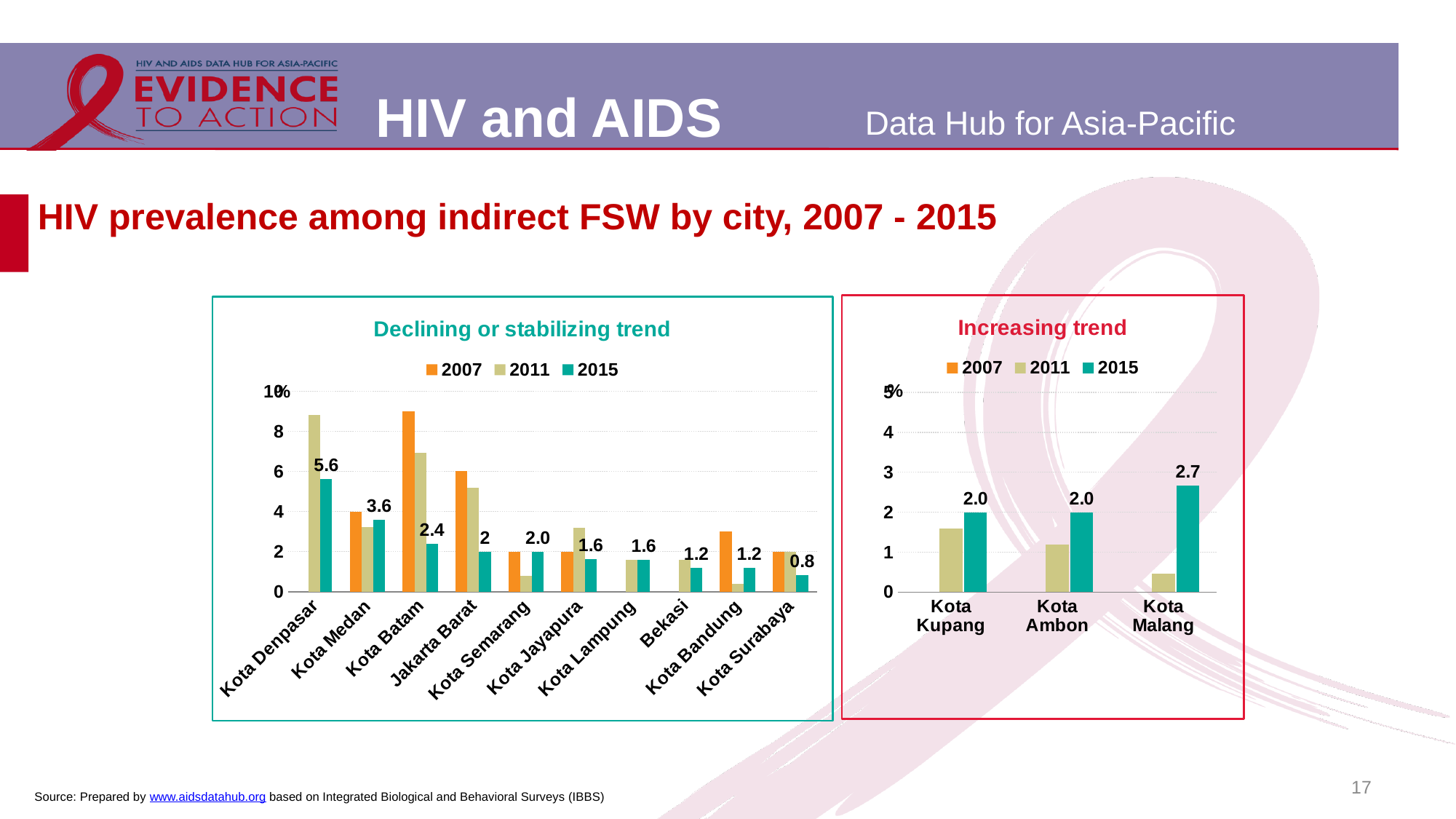
In the 'Increasing trend' chart, which city has the highest 2015 value? Kota Malang How many cities are shown in the 'Declining or stabilizing trend' chart? 10 In the 'Declining or stabilizing trend' chart, which is larger: the 2007 value for Kota Batam or the 2007 value for Kota Medan? Kota Batam In the 'Declining or stabilizing trend' chart, which city has the highest 2015 value? Kota Denpasar In the 'Increasing trend' chart, what is the 2015 value for Kota Malang? 2.7 In the 'Declining or stabilizing trend' chart, is the 2007 value for Kota Batam greater or less than 8? greater In the 'Declining or stabilizing trend' chart, what is the 2015 value for Kota Denpasar? 5.6 How many series does the legend of the 'Increasing trend' chart list? 3 In the 'Declining or stabilizing trend' chart, which city has the lowest 2015 value? Kota Surabaya In the 'Declining or stabilizing trend' chart, what is the difference between the 2015 values for Kota Denpasar and Kota Medan? 2.0 In the 'Increasing trend' chart, what is the difference between the 2015 values for Kota Malang and Kota Kupang? 0.7 In the 'Declining or stabilizing trend' chart, what is the 2015 value for Kota Medan? 3.6